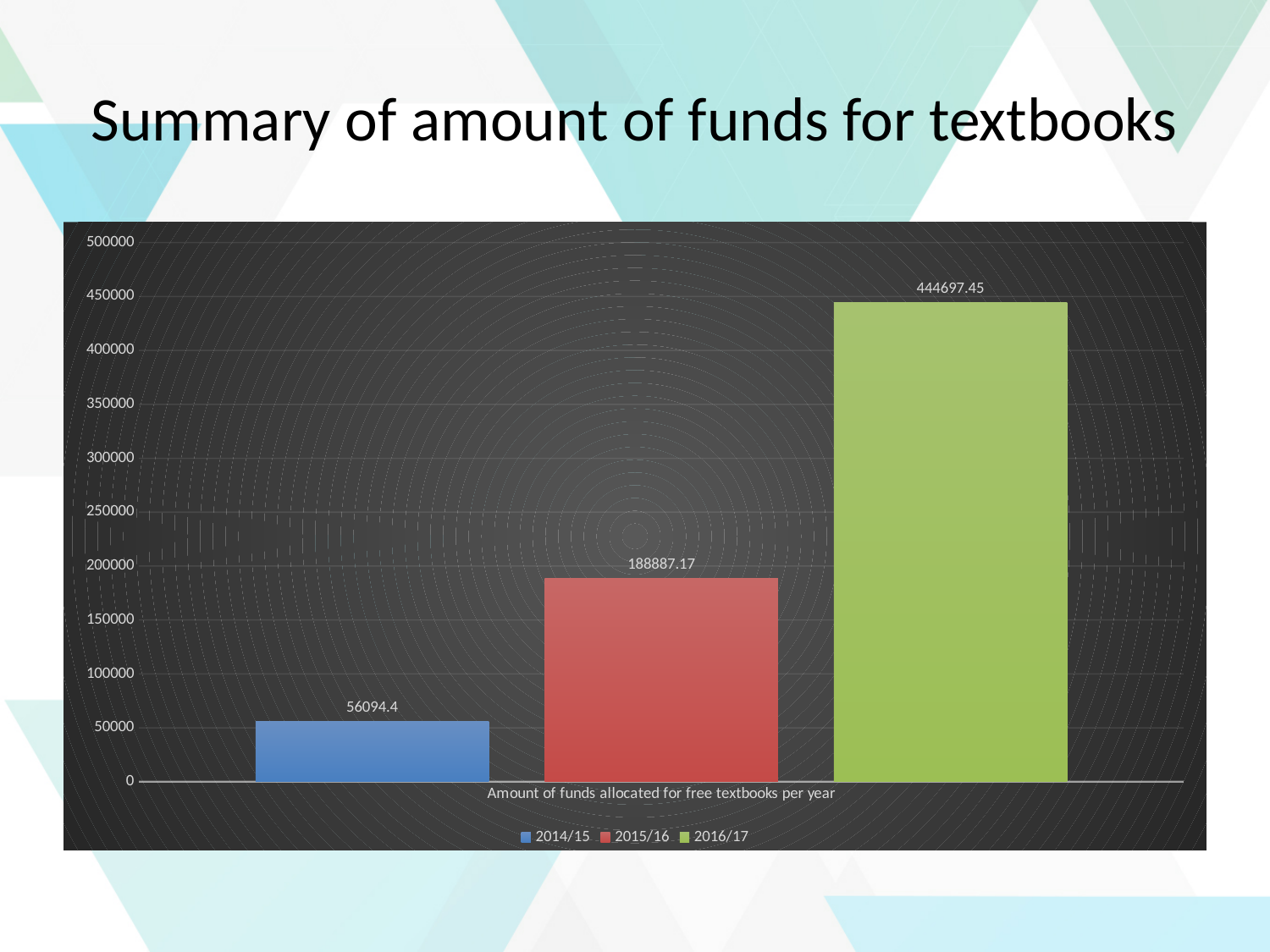
What is the difference between the values for 2016/17 and 2015/16? 255810.28 Is the value for 2016/17 greater or less than 400000? greater Which year has the lowest amount of funds? 2014/15 What is the label on the x axis of the chart? Amount of funds allocated for free textbooks per year What is the value for 2016/17? 444697.45 What kind of chart is shown on the slide? bar chart What is the value for 2014/15? 56094.4 How many series does the legend list? 3 Which year has the highest amount of funds? 2016/17 What is the value for 2015/16? 188887.17 Which is larger, the value for 2015/16 or the value for 2014/15? 2015/16 What is the difference between the values for 2015/16 and 2014/15? 132792.77